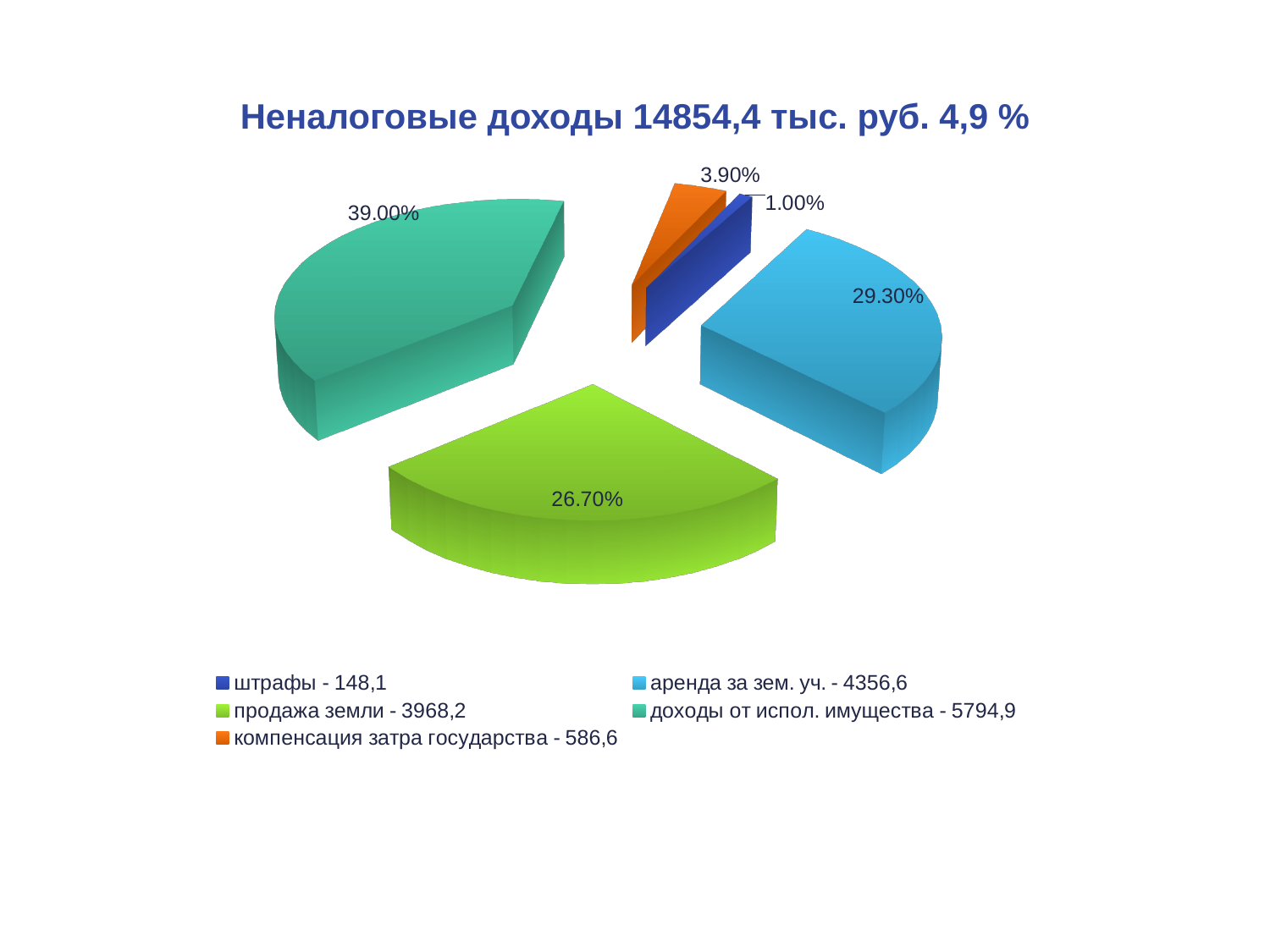
What percentage share is shown for the slice 'доходы от испол. имущества'? 39.00% What is the title of the chart? Неналоговые доходы 14854,4 тыс. руб. 4,9 % How many slices does the pie chart have? 5 What value is listed in the legend for 'аренда за зем. уч.'? 4356,6 What percentage share is shown for the slice 'штрафы'? 1.00% What percentage share is shown for the slice 'продажа земли'? 26.70% What kind of chart is shown on the slide? pie chart Which category has the smallest share of the pie? штрафы Which category has the largest share of the pie? доходы от испол. имущества Which is larger, the share for 'продажа земли' or the share for 'аренда за зем. уч.'? аренда за зем. уч.